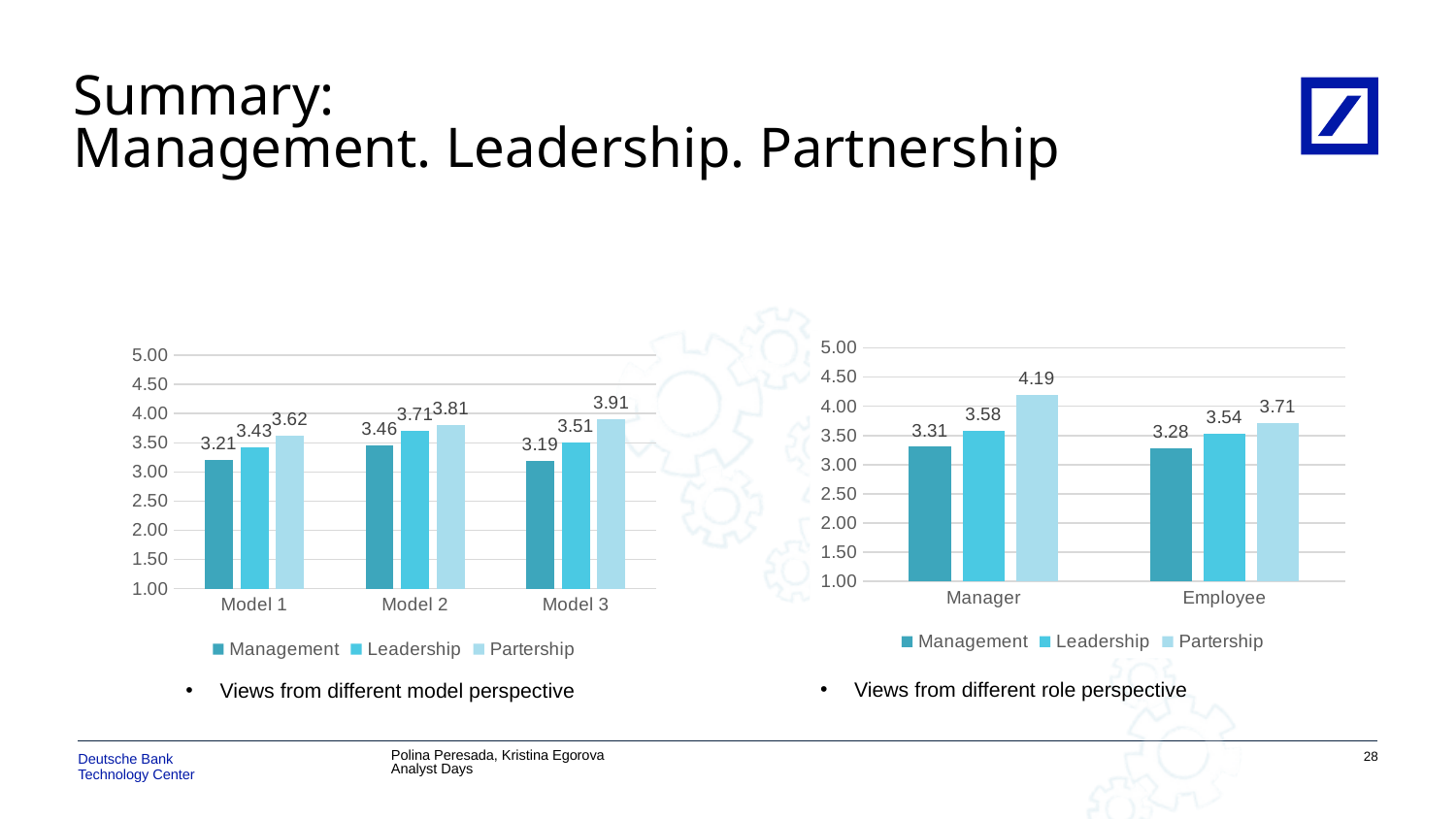
In the left chart, what is the difference between the Leadership and Management values for Model 1? 0.22 In the left chart, what is the Management value for Model 2? 3.46 What type of chart is the right chart? Bar chart In the right chart, which category has the highest Partership value? Manager How many series does the legend of the right chart list? 3 In the left chart, which model has the lowest Management value? Model 3 In the left chart, what is the Partership value for Model 3? 3.91 In the right chart, what is the difference between the Partership values for Manager and Employee? 0.48 In the left chart, which is larger: the Partership value for Model 2 or the Partership value for Model 3? Model 3 In the right chart, is the Partership value for Manager greater or less than 4.00? greater In the right chart, what is the Leadership value for Employee? 3.54 How many categories are shown on the x axis of the left chart? 3